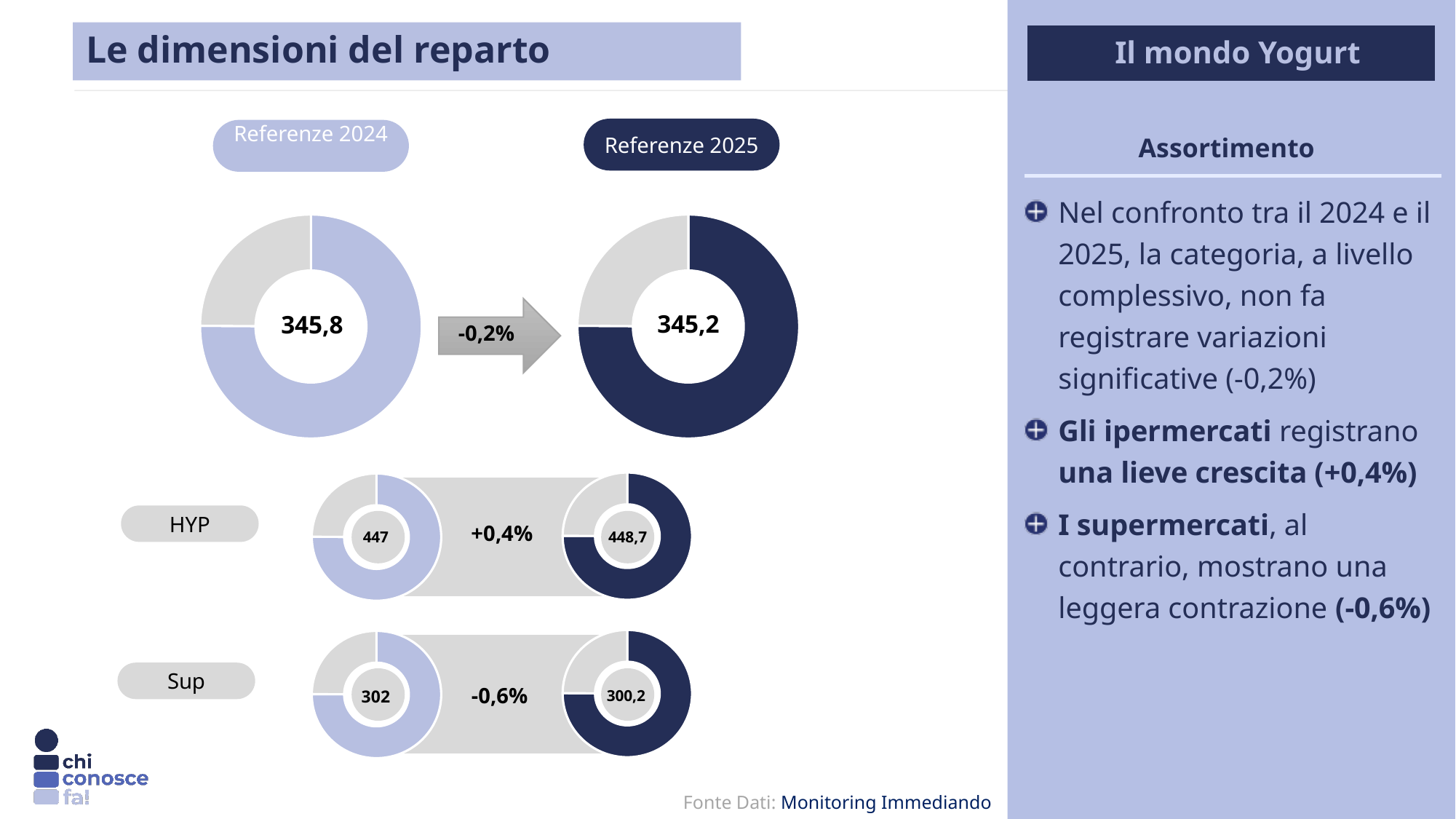
In the HYP row, by how much does the 2025 value (448,7) exceed the 2024 value (447)? 1,7 What value is shown in the centre of the Referenze 2025 donut chart? 345,2 What percentage change is shown between the two Sup donut charts? -0,6% Which has the larger 2025 value, HYP or Sup? HYP What is the difference between the Referenze 2024 value (345,8) and the Referenze 2025 value (345,2)? 0,6 What percentage change is shown on the arrow between the Referenze 2024 and Referenze 2025 donut charts? -0,2% What kind of chart is used to display the Referenze 2024 and Referenze 2025 values? Donut chart What colour is the filled segment of the Referenze 2025 donut chart? Dark navy blue In the Sup row, what value is shown in the 2025 donut chart? 300,2 In the HYP row, what value is shown in the 2024 donut chart? 447 What value is shown in the centre of the Referenze 2024 donut chart? 345,8 In the HYP row, what value is shown in the 2025 donut chart? 448,7